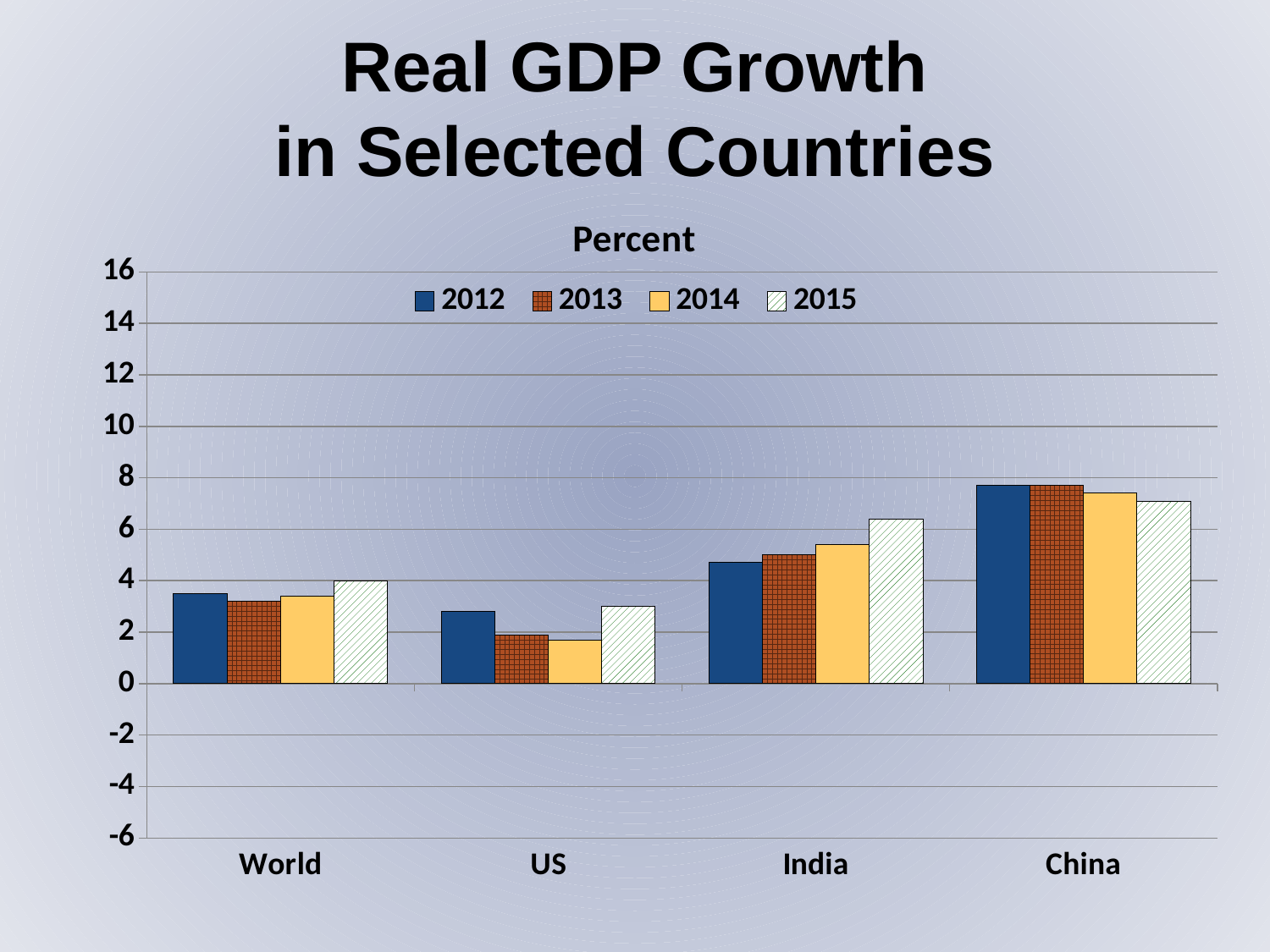
Is the value for US in 2014 greater or less than 2? less Which is larger, the 2015 value for India or the 2015 value for World? India Do the values for India rise or fall from 2012 to 2015? rise Do the values for China rise or fall from 2012 to 2015? fall What kind of chart is shown on the slide? bar chart Is the value for World in 2015 greater or less than 2? greater What are the legend entries of the chart? 2012, 2013, 2014, 2015 How many series does the legend list? 4 Which country or region has the lowest value for 2014? US How many countries or regions are shown on the x axis? 4 Which country or region has the highest value for 2012? China Is the value for China in 2012 greater or less than 6? greater